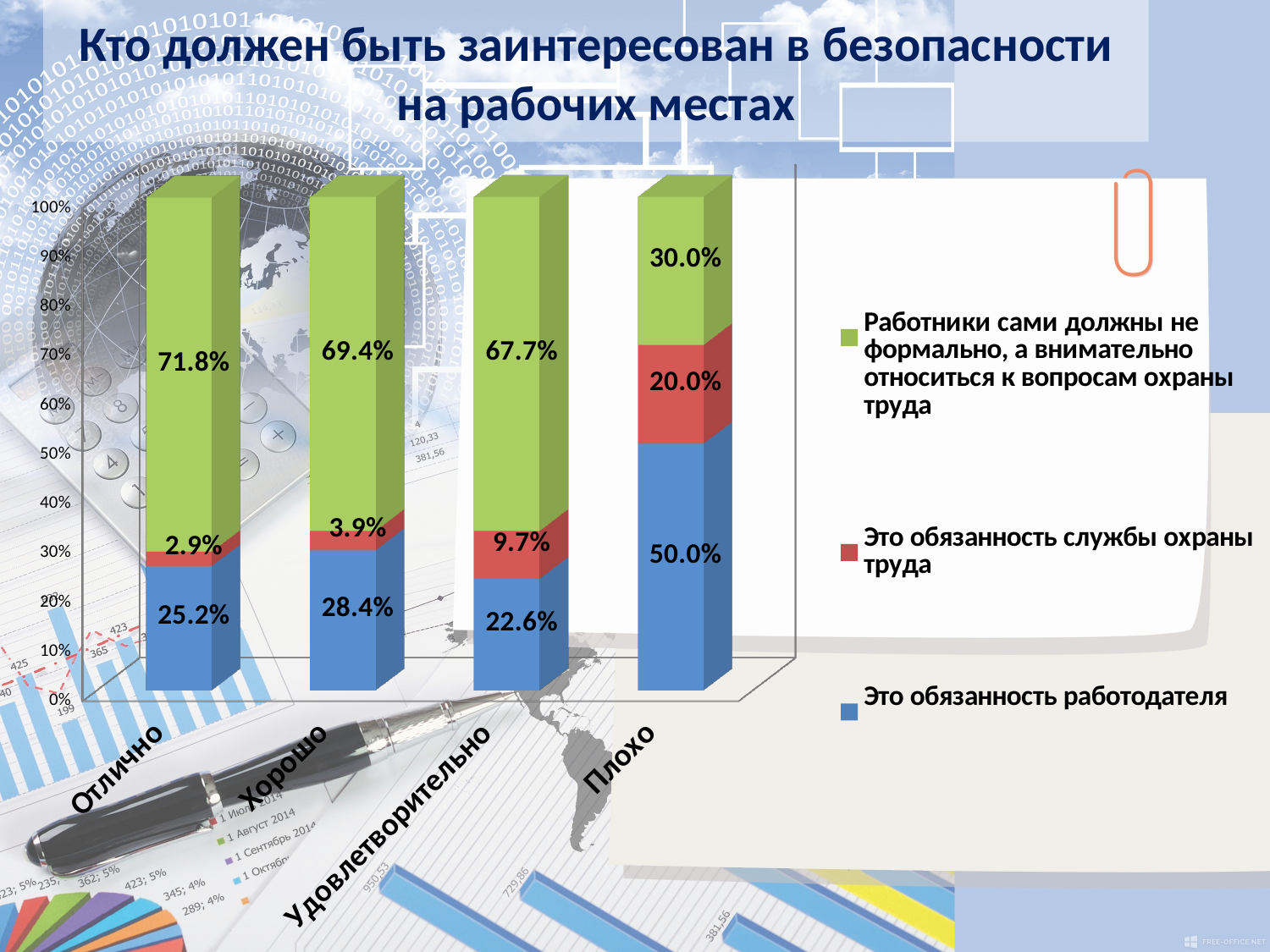
What is the difference between the 'Это обязанность работодателя' values for 'Хорошо' and 'Отлично'? 3.2% Which colour represents 'Это обязанность работодателя' in the chart? Blue Which category has the highest value for 'Это обязанность службы охраны труда'? Плохо What is the value of 'Работники сами должны не формально, а внимательно относиться к вопросам охраны труда' for the category 'Отлично'? 71.8% What type of chart is shown on the slide? Stacked bar chart Which category has the lowest value for 'Работники сами должны не формально, а внимательно относиться к вопросам охраны труда'? Плохо How many series does the chart legend list? 3 Which is larger: the 'Это обязанность службы охраны труда' value for 'Хорошо' or for 'Отлично'? Хорошо What is the value of 'Это обязанность службы охраны труда' for the category 'Удовлетворительно'? 9.7% What is the value of 'Это обязанность работодателя' for the category 'Плохо'? 50.0% How many categories are shown on the x axis of the chart? 4 Does the value of 'Работники сами должны не формально, а внимательно относиться к вопросам охраны труда' rise or fall from 'Отлично' to 'Плохо' along the x axis? Fall